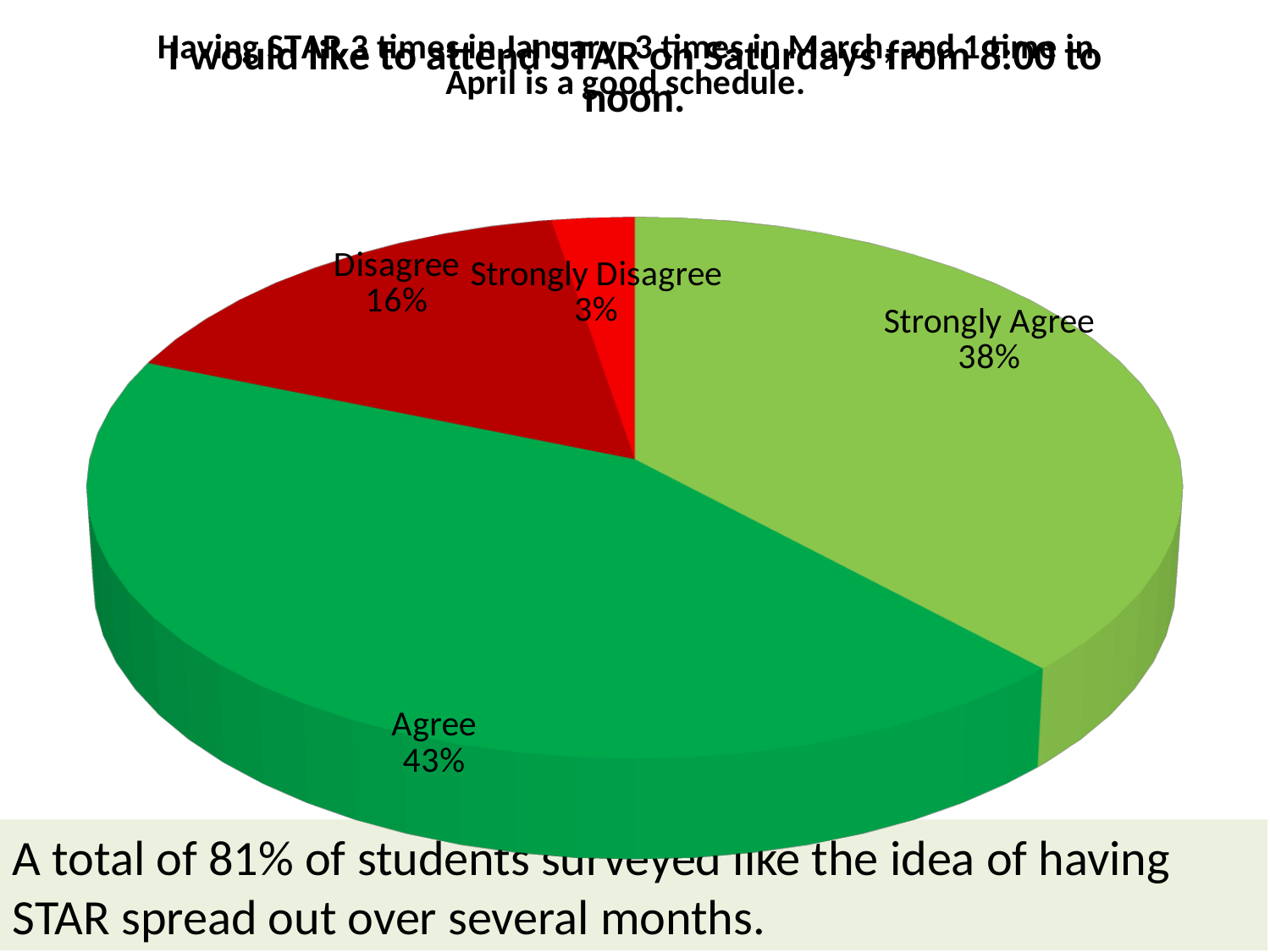
What percentage of students chose Strongly Disagree? 3% Which is larger, the share for Disagree or the share for Strongly Agree? Strongly Agree What is the difference in percentage points between Agree and Strongly Agree? 5 Which response has the largest share of the pie? Agree How many slices does the pie chart have? 4 What is the difference in percentage points between Disagree and Strongly Disagree? 13 Which response has the smallest share of the pie? Strongly Disagree What percentage of students chose Agree? 43% What kind of chart is shown on the slide? pie chart What percentage of students chose Strongly Agree? 38% What percentage of students chose Disagree? 16% What is the combined share of Strongly Agree and Agree? 81%